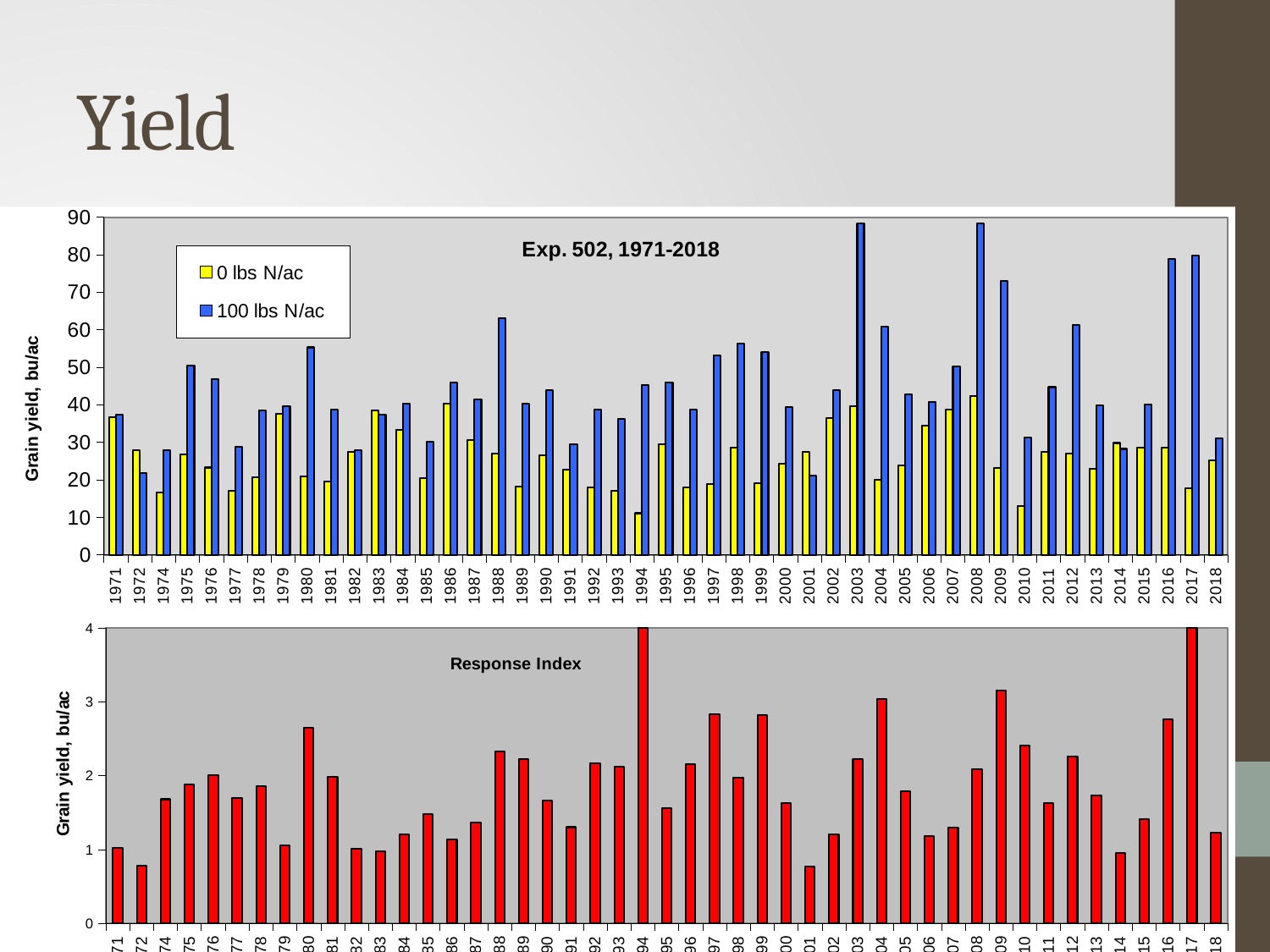
In the top chart (Exp. 502, 1971-2018), which year has the larger 100 lbs N/ac value, 2003 or 2004? 2003 In the top chart (Exp. 502, 1971-2018), how many series does the legend list? 2 In the top chart (Exp. 502, 1971-2018), is the value for 100 lbs N/ac in 1988 greater or less than 60? greater In the bottom chart (Response Index), which year has the larger value, 2009 or 2010? 2009 What kind of chart is the bottom chart titled Response Index? bar chart In the bottom chart (Response Index), is the value for 2001 greater or less than 1? less In the top chart (Exp. 502, 1971-2018), is the value for 100 lbs N/ac in 2016 greater or less than 70? greater In the top chart (Exp. 502, 1971-2018), which year has the larger 0 lbs N/ac value, 1985 or 1986? 1986 What is the title of the top chart on the slide? Exp. 502, 1971-2018